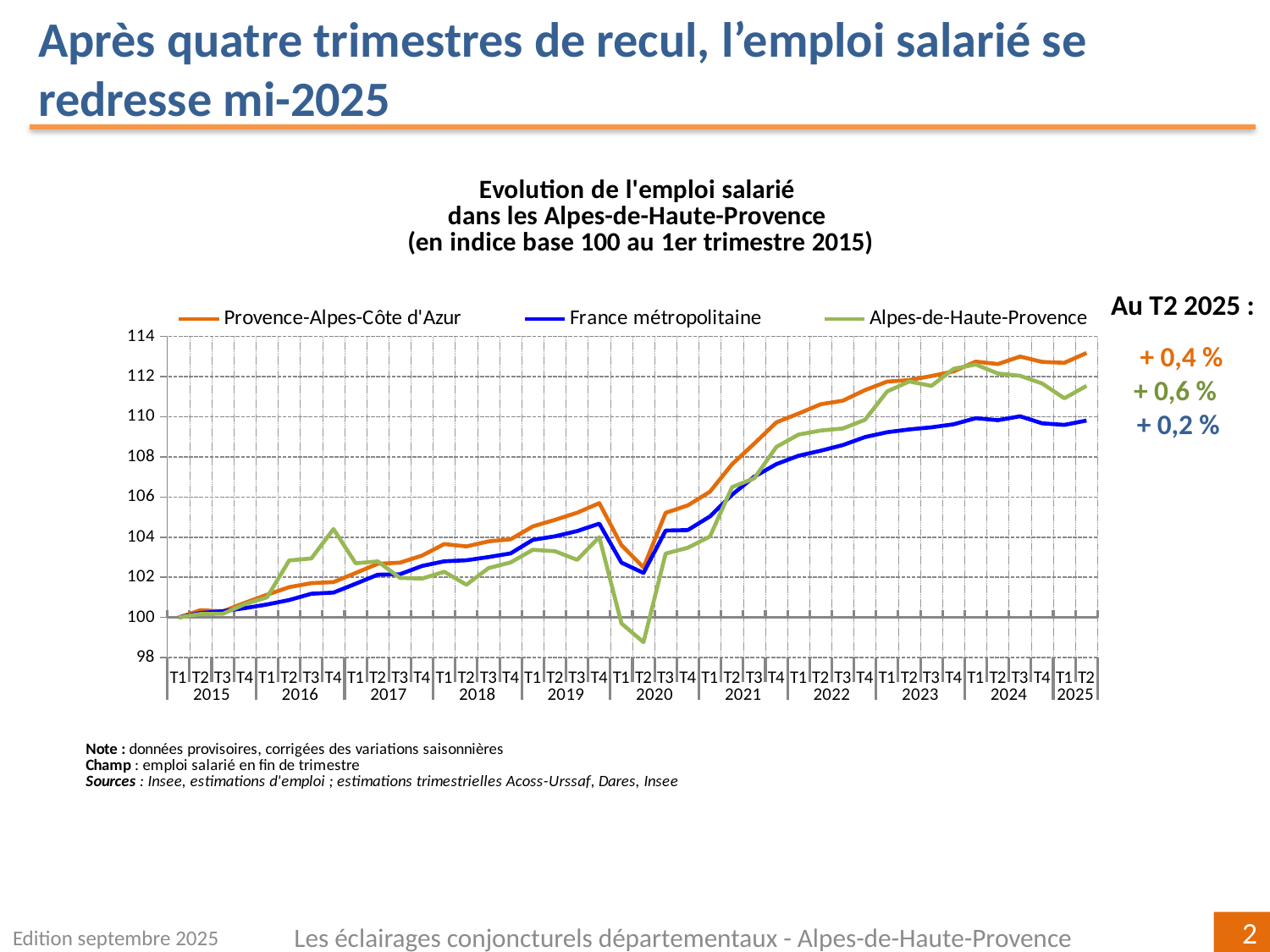
How many series does the legend list? 3 Is the value for Provence-Alpes-Côte d'Azur at T2 2025 greater or less than 112? greater What kind of chart is shown on the slide? line chart Is the value for Alpes-de-Haute-Provence at T2 2020 greater or less than 100? less Overall, do the index values rise or fall from T1 2015 to T2 2025? rise Which three series are listed in the legend? Provence-Alpes-Côte d'Azur, France métropolitaine, Alpes-de-Haute-Provence At T4 2016, which is larger: the value for Alpes-de-Haute-Provence or for France métropolitaine? Alpes-de-Haute-Provence Which series has the highest value at T2 2025? Provence-Alpes-Côte d'Azur How many years are labelled on the x axis? 11 Is the value for France métropolitaine at T2 2025 greater or less than 112? less Which series has the lowest value at T2 2025? France métropolitaine According to the annotation 'Au T2 2025', what is the change shown for Alpes-de-Haute-Provence (green)? + 0,6 %